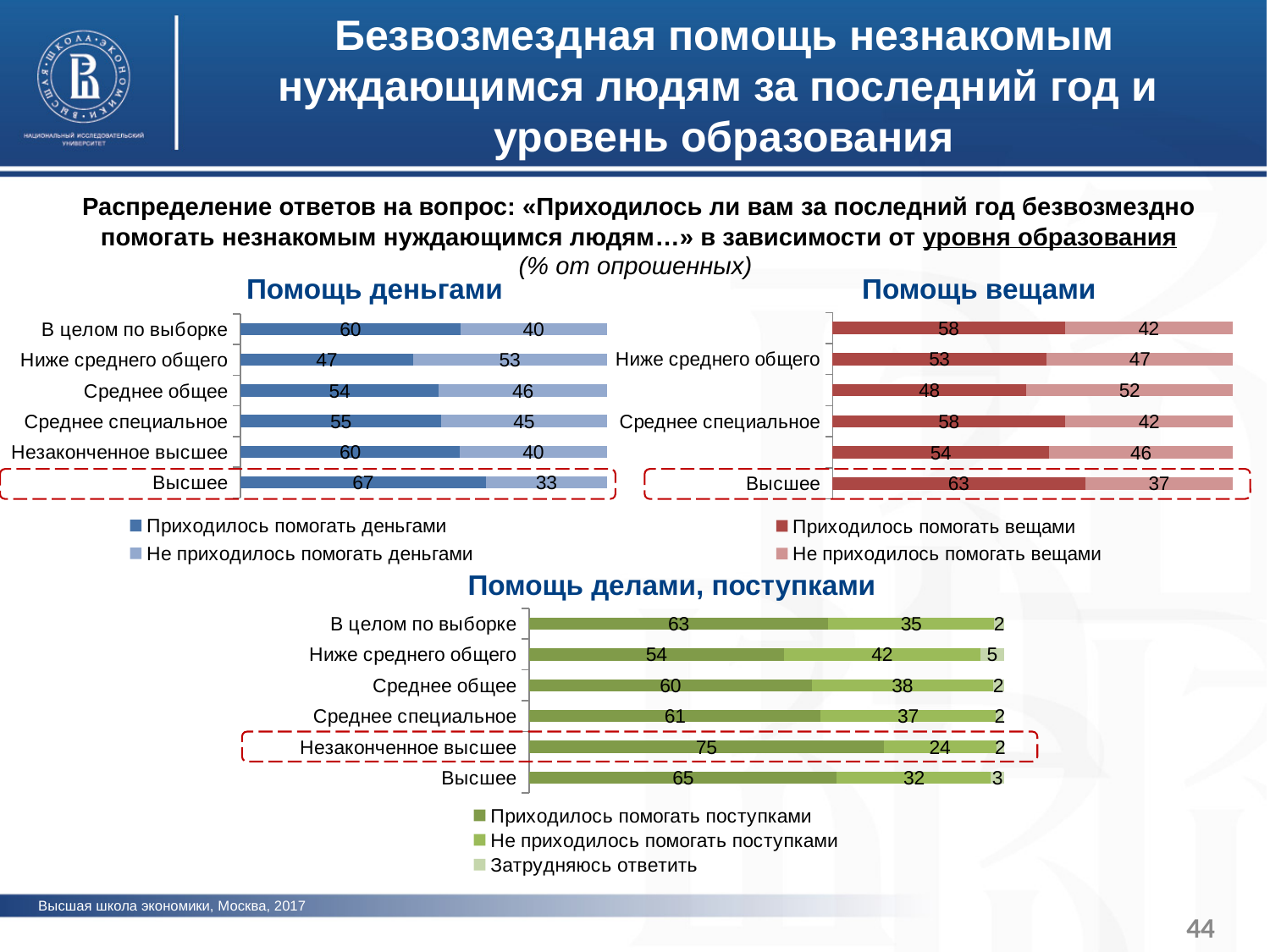
How many series does the legend of the 'Помощь делами, поступками' chart list? 3 In the 'Помощь деньгами' chart, which category has the highest value for 'Приходилось помогать деньгами'? Высшее How many categories are shown in the 'Помощь делами, поступками' chart? 6 In the 'Помощь вещами' chart, what is the value of 'Не приходилось помогать вещами' for 'Высшее'? 37 In the 'Помощь деньгами' chart, what is the total of the stacked bar for 'Высшее'? 100 In the 'Помощь деньгами' chart, what is the value of 'Приходилось помогать деньгами' for 'Высшее'? 67 In the 'Помощь деньгами' chart, what is the difference between the 'Приходилось помогать деньгами' values for 'Высшее' and 'Ниже среднего общего'? 20 In the 'Помощь вещами' chart, what is the value of 'Приходилось помогать вещами' for 'Ниже среднего общего'? 53 In the 'Помощь делами, поступками' chart, which is larger for 'Приходилось помогать поступками': 'Незаконченное высшее' or 'Высшее'? Незаконченное высшее In the 'Помощь делами, поступками' chart, what is the value of 'Затрудняюсь ответить' for 'Ниже среднего общего'? 5 In the 'Помощь деньгами' chart, which category has the lowest value for 'Приходилось помогать деньгами'? Ниже среднего общего In the 'Помощь делами, поступками' chart, what is the value of 'Приходилось помогать поступками' for 'Незаконченное высшее'? 75